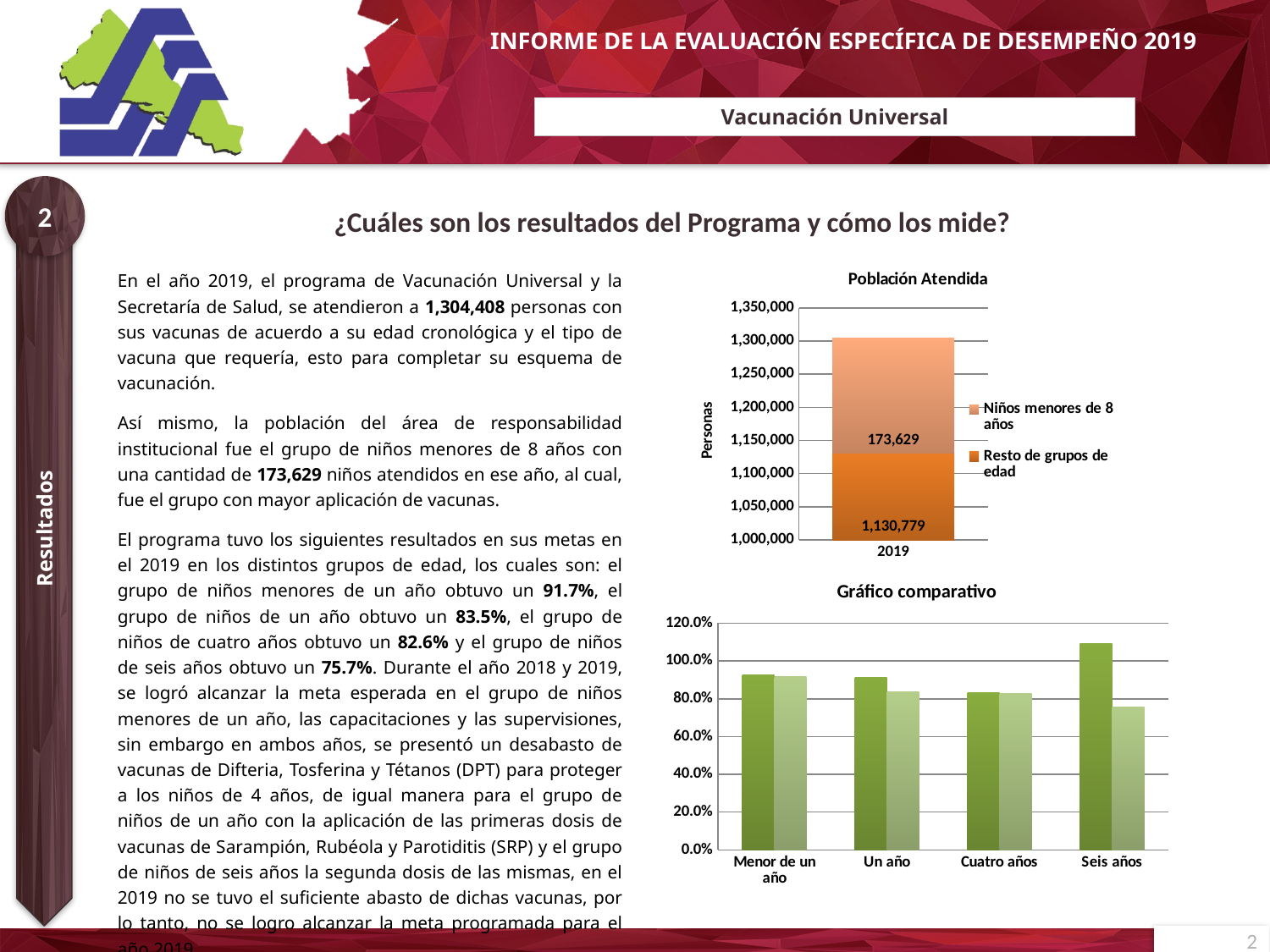
What kind of chart is the 'Gráfico comparativo'? Bar chart In the 'Gráfico comparativo' chart, is the dark green bar for 'Seis años' greater or less than 100.0%? greater In the 'Población Atendida' chart, how many series does the legend list? 2 In the 'Población Atendida' chart, what is the value for 'Resto de grupos de edad' in 2019? 1,130,779 In the 'Población Atendida' chart, which series is larger in 2019, 'Niños menores de 8 años' or 'Resto de grupos de edad'? Resto de grupos de edad In the 'Población Atendida' chart, what is the difference between 'Resto de grupos de edad' and 'Niños menores de 8 años'? 957,150 In the 'Población Atendida' chart, what is the value for 'Niños menores de 8 años' in 2019? 173,629 In the 'Gráfico comparativo' chart, which category has the highest dark green bar? Seis años In the 'Gráfico comparativo' chart, how many categories are shown on the x axis? 4 In the 'Gráfico comparativo' chart, do the light green bars rise or fall from 'Menor de un año' to 'Seis años'? fall In the 'Gráfico comparativo' chart, is the light green bar for 'Seis años' greater or less than 80.0%? less In the 'Población Atendida' chart, what is the total of the stacked bar for 2019? 1,304,408